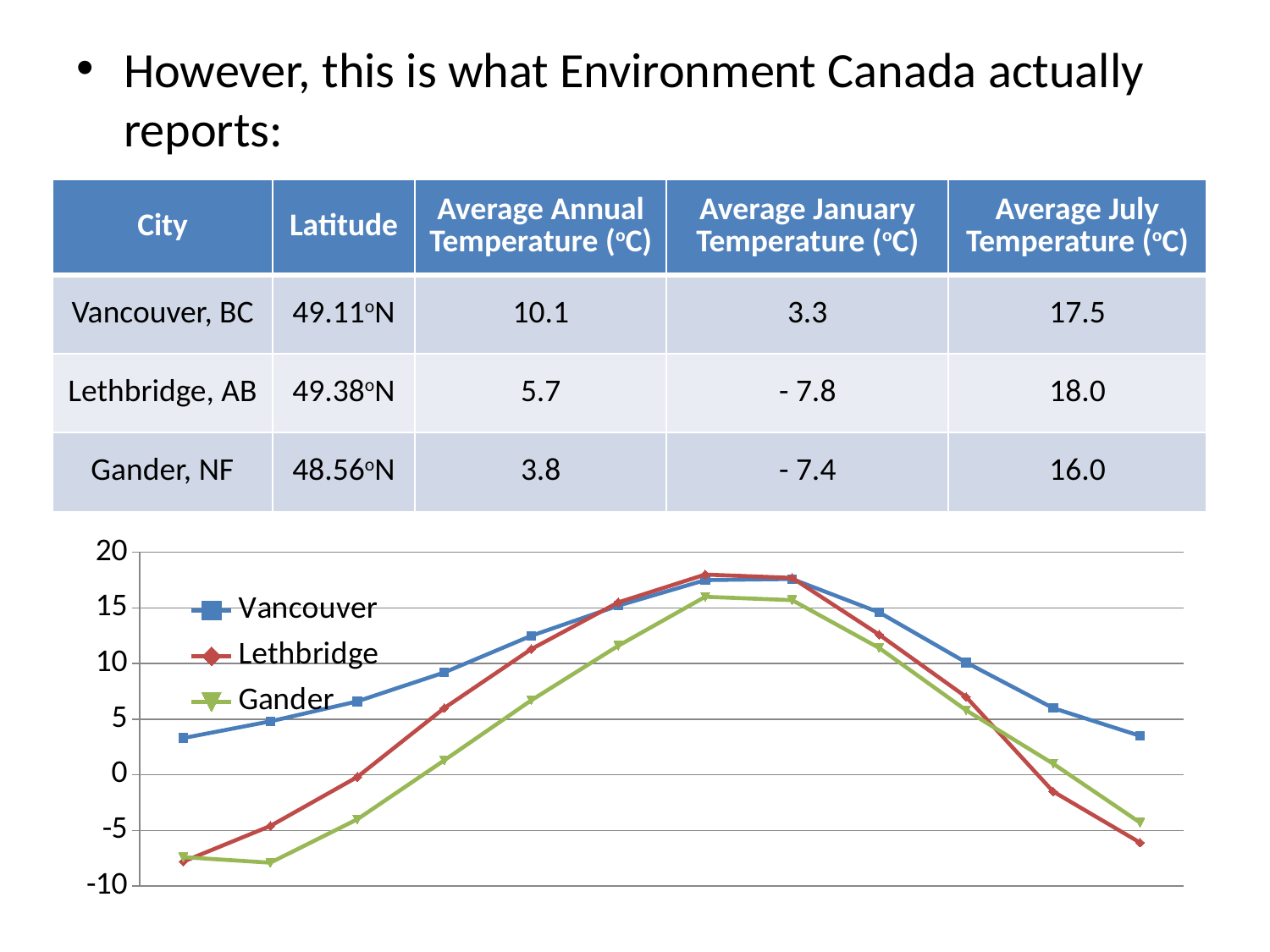
Is the first value of the Vancouver line greater or less than 0? greater Which series uses diamond markers on the chart? Lethbridge Which series is drawn in green on the chart? Gander Is the first value of the Lethbridge line greater or less than -5? less At the first point on the x axis, which series has the higher value, Vancouver or Lethbridge? Vancouver At the last point on the x axis, which series has the highest value? Vancouver At the last point on the x axis, which series has the lowest value? Lethbridge Is the highest value of the Gander line greater or less than 20? less How many data points does the Vancouver line have? 12 How many series does the chart's legend list? 3 What kind of chart is shown at the bottom of the slide? line chart